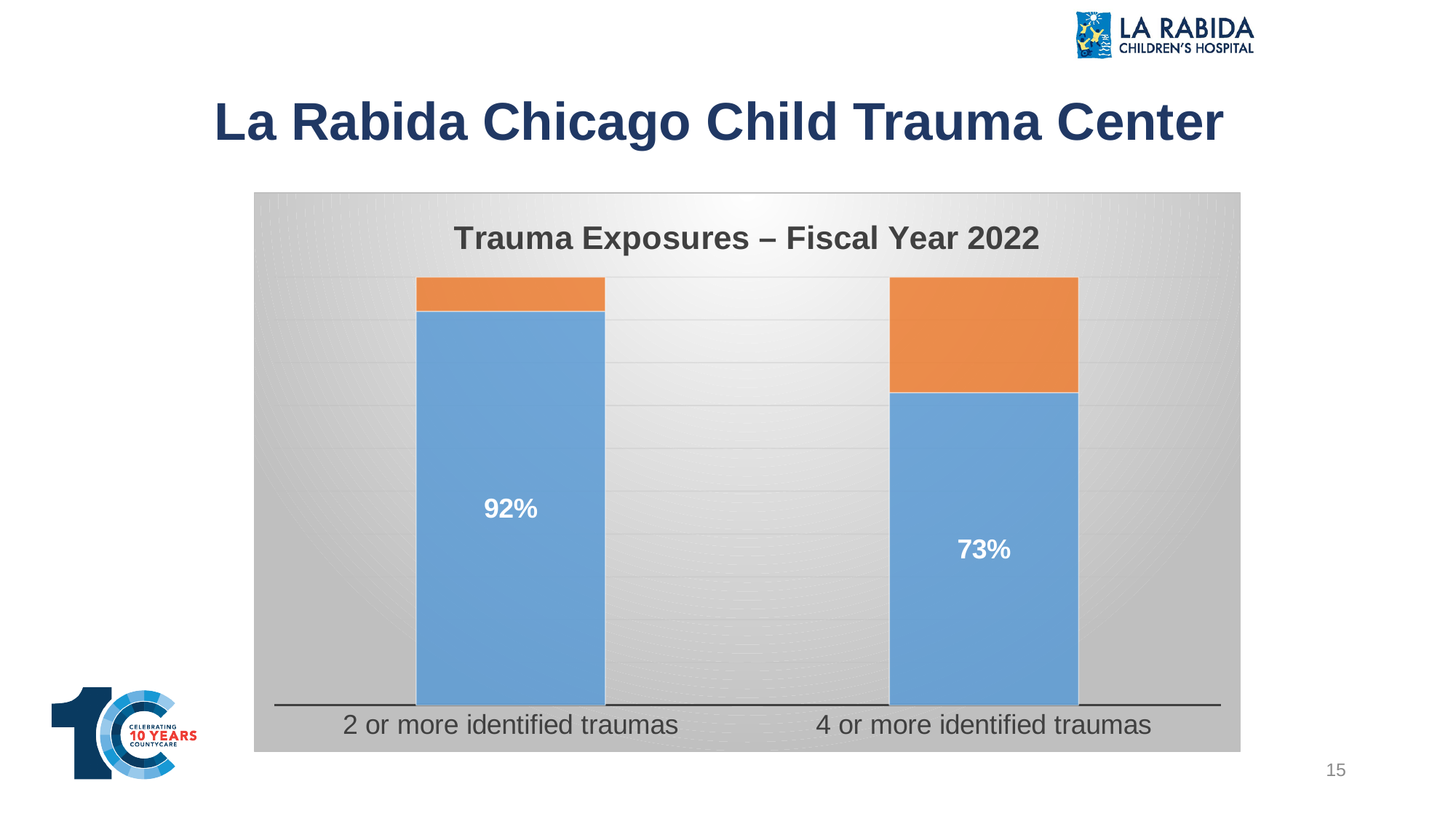
Do the labelled blue values rise or fall from left to right along the x axis? Fall How many categories are shown on the x axis? 2 What kind of chart is shown on the slide? Stacked bar chart Which category has the higher labelled blue value? 2 or more identified traumas Is the labelled value larger for "2 or more identified traumas" or for "4 or more identified traumas"? 2 or more identified traumas What is the title of the chart? Trauma Exposures – Fiscal Year 2022 What is the blue segment value for "2 or more identified traumas"? 92% What is the blue segment value for "4 or more identified traumas"? 73% What colour is the segment that carries the percentage labels in each bar? Blue Which category has the lower labelled blue value? 4 or more identified traumas What is the difference between the labelled values for "2 or more identified traumas" and "4 or more identified traumas"? 19 percentage points